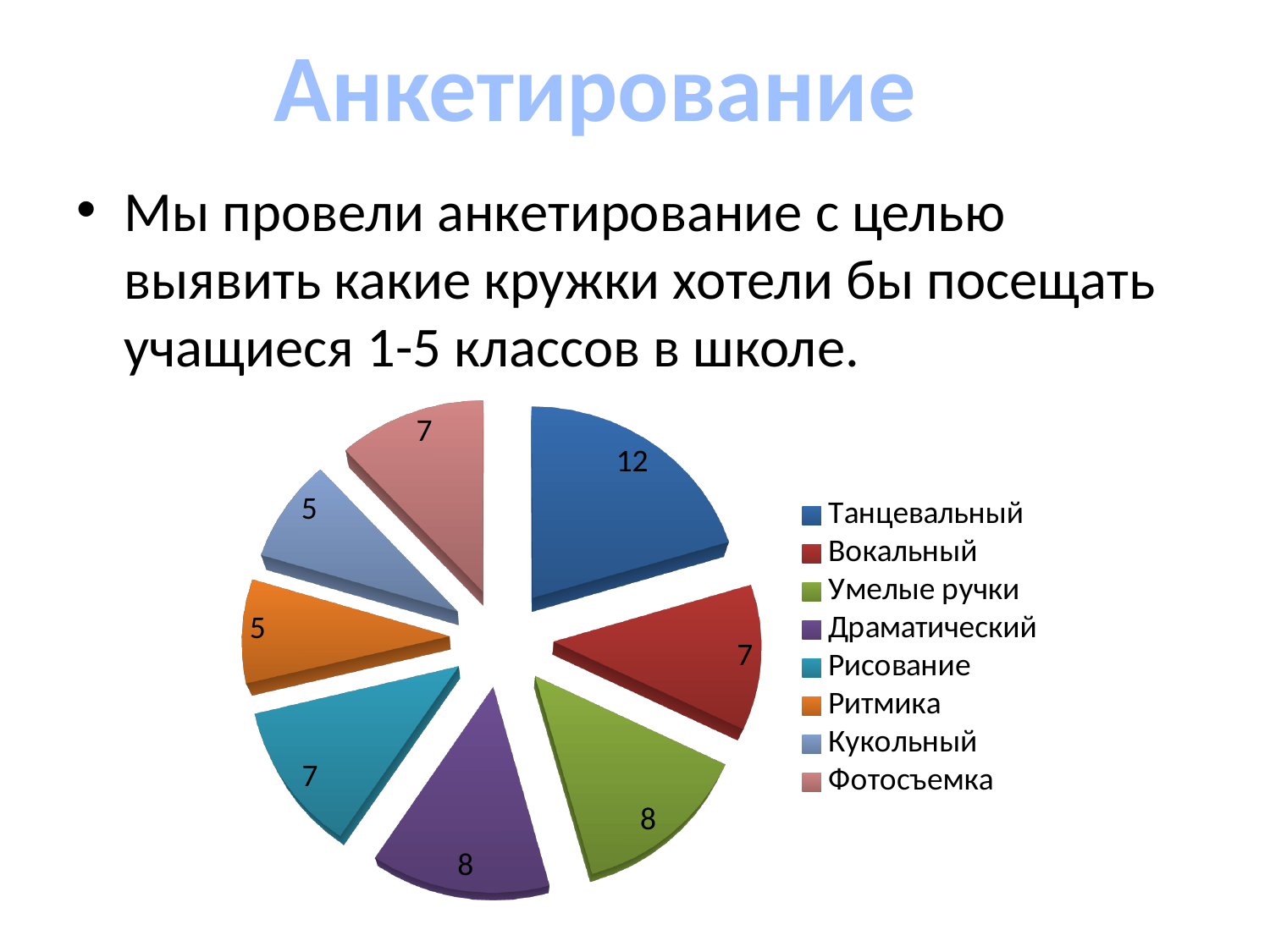
Which category has the highest value? Танцевальный What is the value for Ритмика? 5 What is the value for Танцевальный? 12 What kind of chart is shown on the slide? pie chart What is the value for Умелые ручки? 8 How many entries does the legend list? 8 Which is larger, the value for Драматический or the value for Рисование? Драматический What is the total of all the values in the pie chart? 59 How many slices does the pie chart have? 8 What is the difference between the values for Танцевальный and Вокальный? 5 Which categories have the lowest value? Ритмика and Кукольный What is the value for Фотосъемка? 7